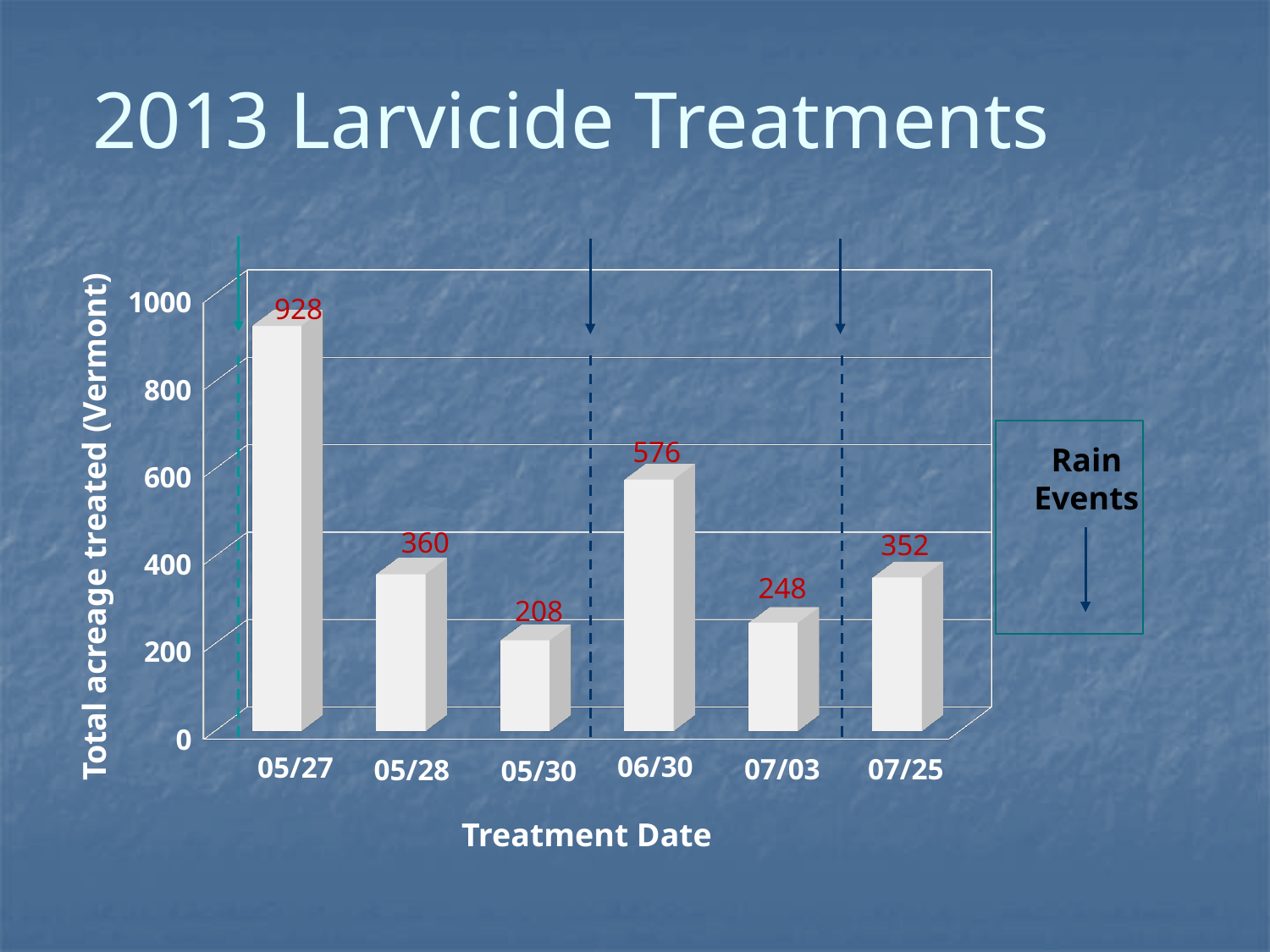
What is the difference in acreage treated between 05/28 and 07/25? 8 What is the difference in acreage treated between 05/27 and 06/30? 352 Which date had more acreage treated, 07/03 or 07/25? 07/25 Is the value for 05/30 greater or less than 400? less What is the total acreage treated on 05/27? 928 Which treatment date has the highest total acreage treated? 05/27 How many treatment dates are shown on the chart? 6 What is the total acreage treated on 07/03? 248 What is the title of the slide? 2013 Larvicide Treatments What kind of chart is shown on the slide? bar chart What is the total acreage treated on 06/30? 576 Which treatment date has the lowest total acreage treated? 05/30